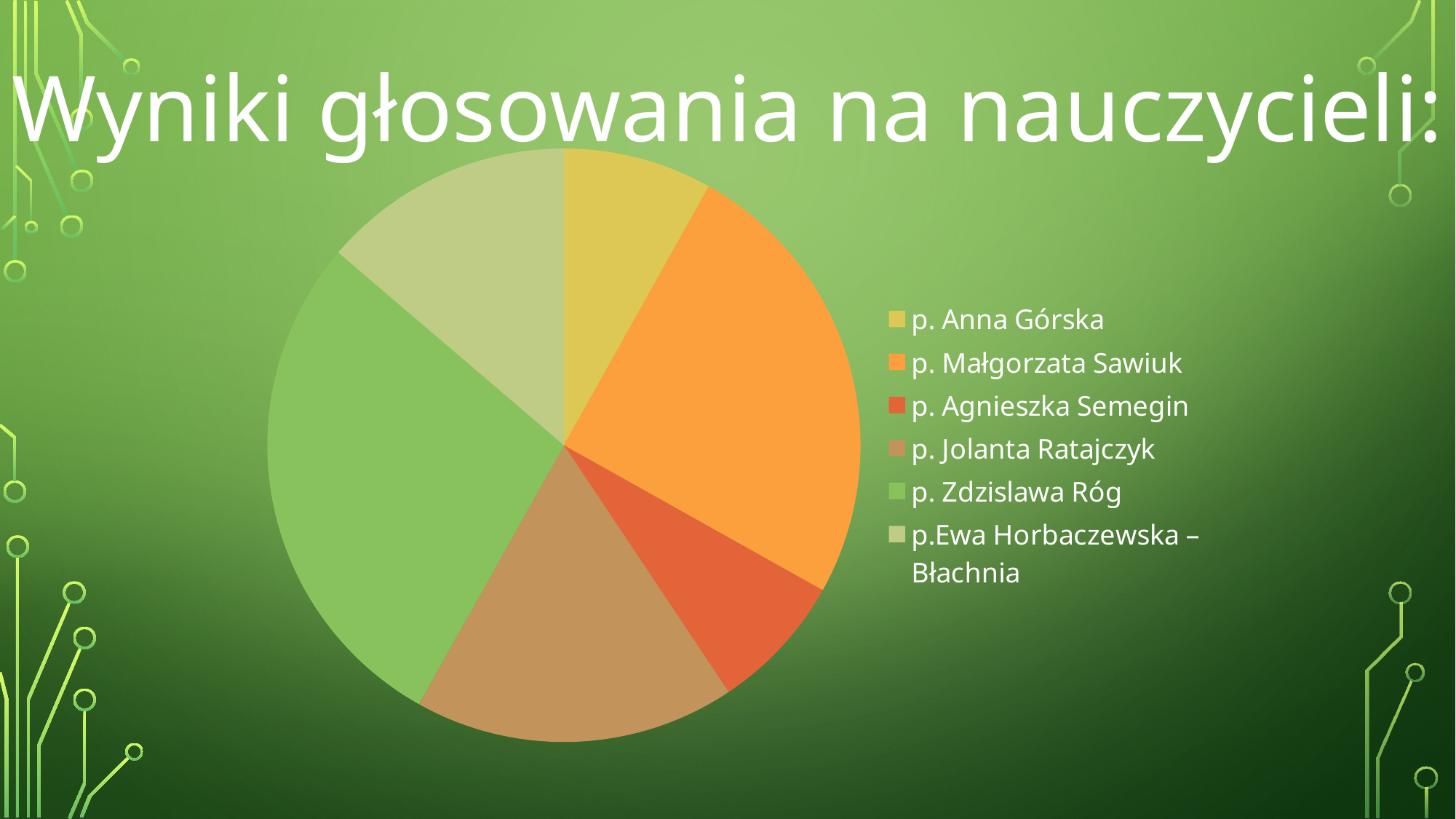
How many categories (teachers) does the pie chart show? 6 What is the title of the slide with the pie chart? Wyniki głosowania na nauczycieli: What kind of chart is shown on the slide? pie chart Which slice is larger: p. Zdzislawa Róg or p. Anna Górska? p. Zdzislawa Róg Which slice is larger: p. Małgorzata Sawiuk or p.Ewa Horbaczewska – Błachnia? p. Małgorzata Sawiuk Which slice is larger: p. Jolanta Ratajczyk or p. Agnieszka Semegin? p. Jolanta Ratajczyk Which colour represents p. Zdzislawa Róg in the pie chart? green